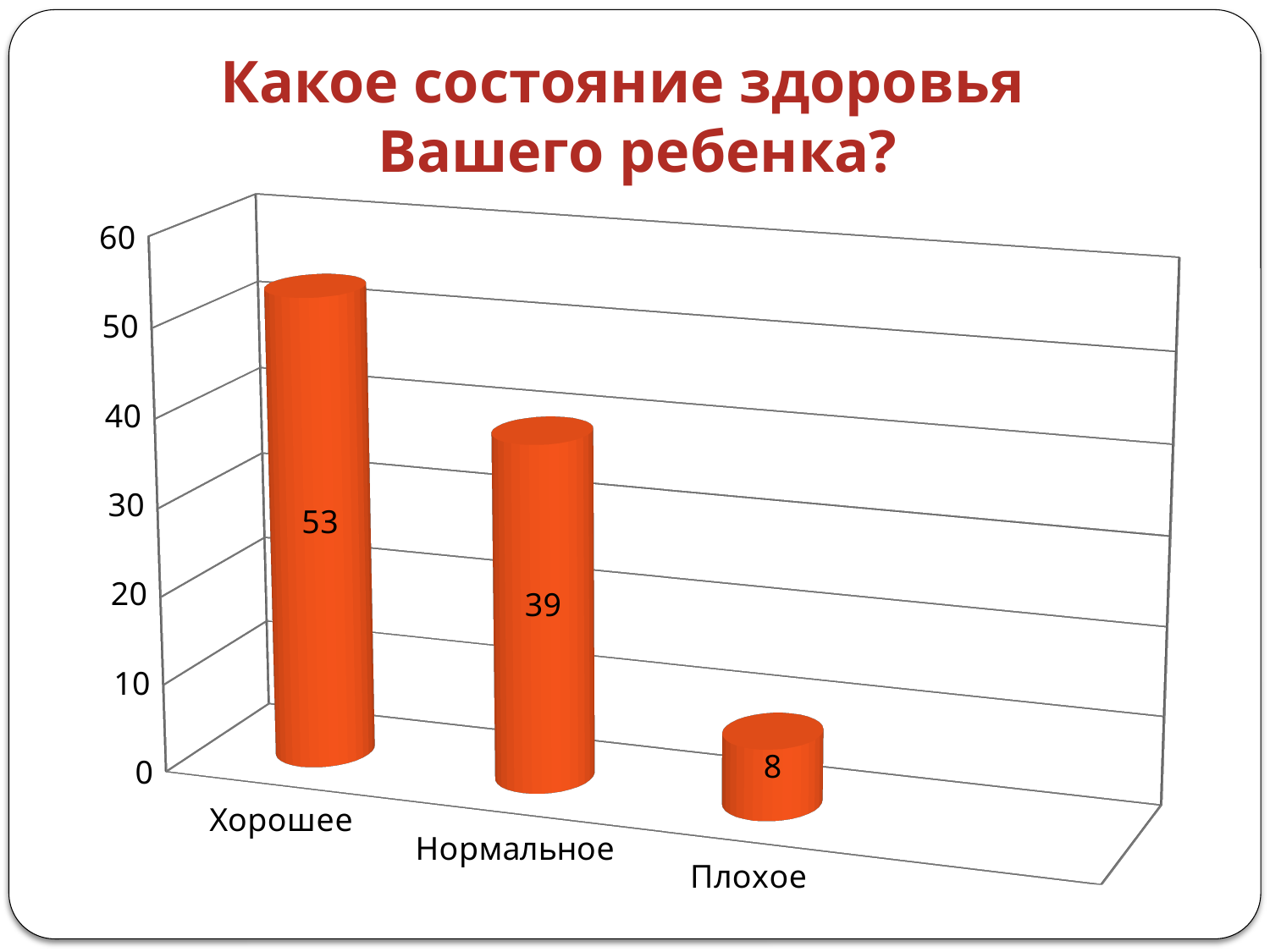
Which is larger, the value for Нормальное or the value for Плохое? Нормальное How many categories are shown on the chart? 3 What is the difference between the values for Нормальное and Плохое? 31 What is the value for Нормальное? 39 What kind of chart is shown on the slide? bar chart What is the value for Плохое? 8 Which category has the highest value? Хорошее What is the difference between the values for Хорошее and Нормальное? 14 What is the title of the chart? Какое состояние здоровья Вашего ребенка? Is the value for Хорошее greater or less than 50? greater Which category has the lowest value? Плохое What is the value for Хорошее? 53